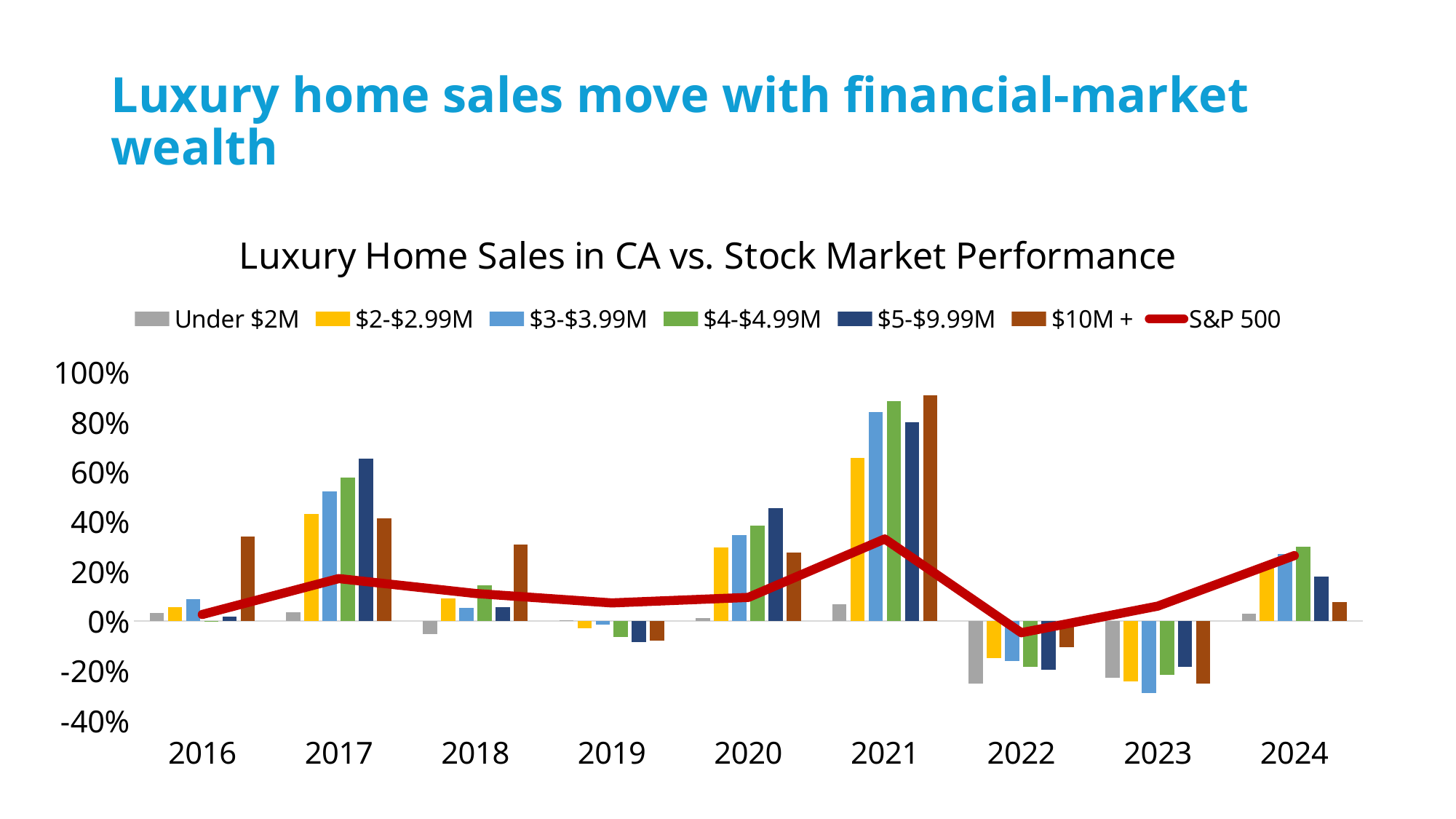
How many series does the legend list? 7 Does the S&P 500 line rise or fall from 2022 to 2024? Rise What kind of chart is this? Combination bar and line chart How many years are shown on the x axis? 9 In which year is the $3-$3.99M bar lowest? 2023 In which year is the $10M + bar lowest? 2023 What is the title of the chart? Luxury Home Sales in CA vs. Stock Market Performance In which year is the $10M + bar highest? 2021 Which is larger: the $10M + value in 2017 or the $10M + value in 2021? 2021 Is the value for $5-$9.99M in 2017 greater or less than 60%? greater Is the S&P 500 value in 2022 greater or less than 0%? less Is the value for $10M + in 2021 greater or less than 80%? greater